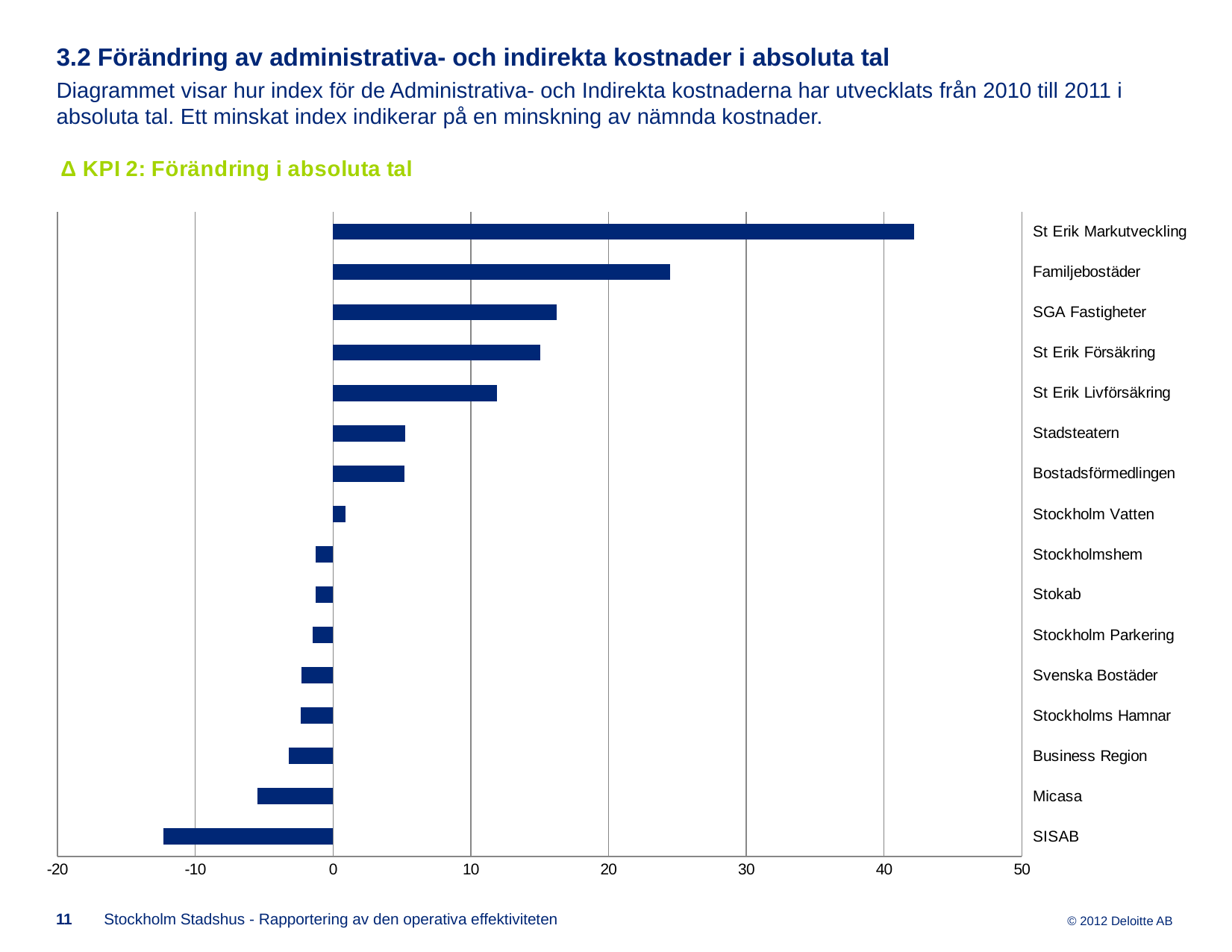
What kind of chart is shown on the slide? bar chart What is the title of the chart shown on the slide? Δ KPI 2: Förändring i absoluta tal Which category has the highest value in the chart? St Erik Markutveckling Which category has the lowest value in the chart? SISAB Is the value for St Erik Markutveckling greater or less than 40? greater Which has the larger value, Familjebostäder or SGA Fastigheter? Familjebostäder Is the value for Familjebostäder greater or less than 20? greater Is the value for Micasa greater or less than -10? greater How many categories (companies) are plotted in the chart? 16 Which has the larger value, Stadsteatern or Micasa? Stadsteatern